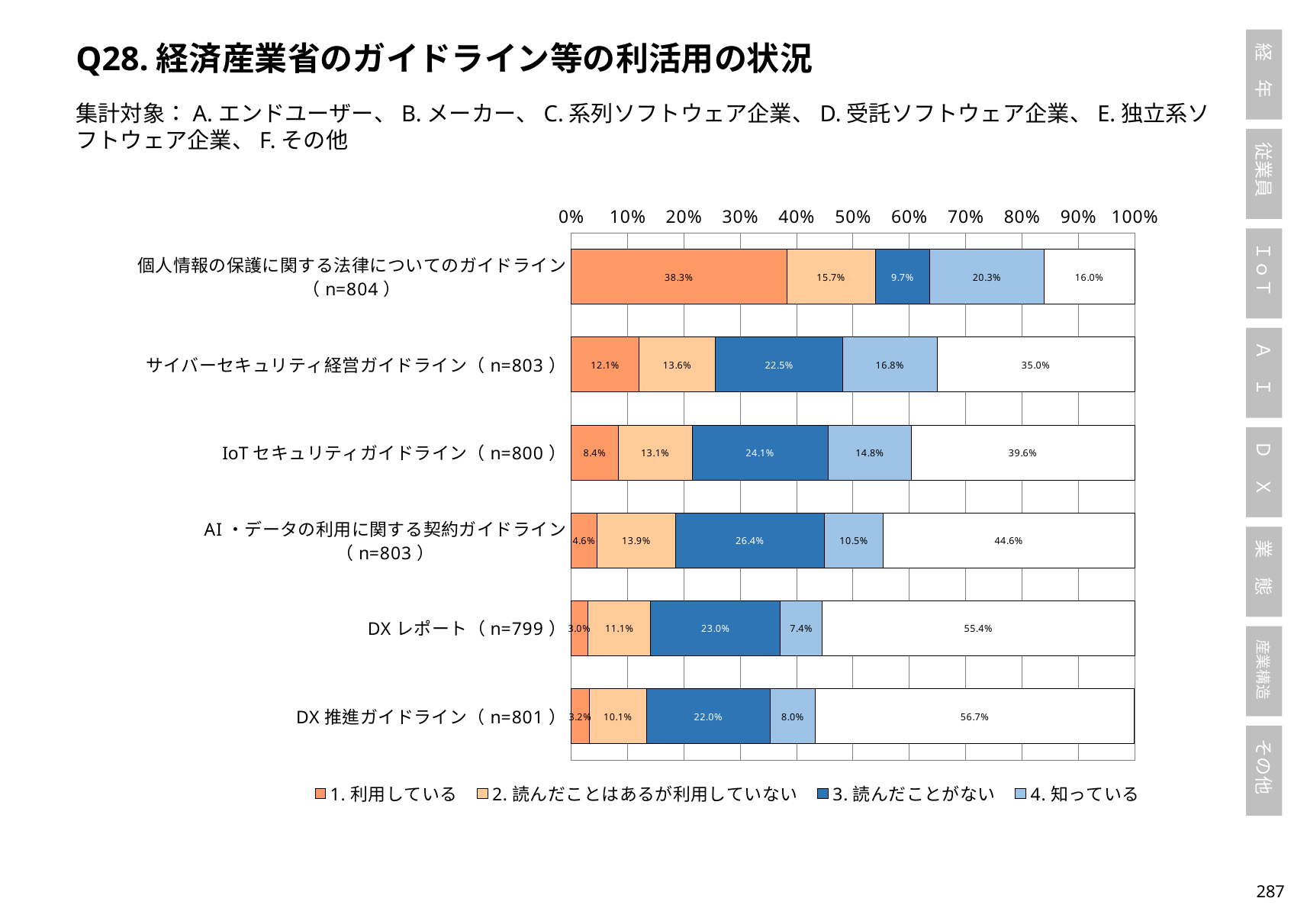
Which guideline has the highest value for "1. 利用している"? 個人情報の保護に関する法律についてのガイドライン (n=804) What is the value of "1. 利用している" for 個人情報の保護に関する法律についてのガイドライン (n=804)? 38.3% How many guidelines (categories) are shown in the chart? 6 Which has the larger value for "3. 読んだことがない": IoTセキュリティガイドライン or サイバーセキュリティ経営ガイドライン? IoTセキュリティガイドライン Which guideline has the lowest value for "1. 利用している"? DXレポート (n=799) What is the value of "3. 読んだことがない" for AI・データの利用に関する契約ガイドライン (n=803)? 26.4% Which guideline has the highest value for "3. 読んだことがない"? AI・データの利用に関する契約ガイドライン (n=803) What is the first entry in the chart legend? 1. 利用している How many series does the legend list? 4 What kind of chart is shown on the slide? Stacked bar chart What is the difference in "4. 知っている" between 個人情報の保護に関する法律についてのガイドライン and サイバーセキュリティ経営ガイドライン? 3.5 percentage points What is the value of "2. 読んだことはあるが利用していない" for DX推進ガイドライン (n=801)? 10.1%